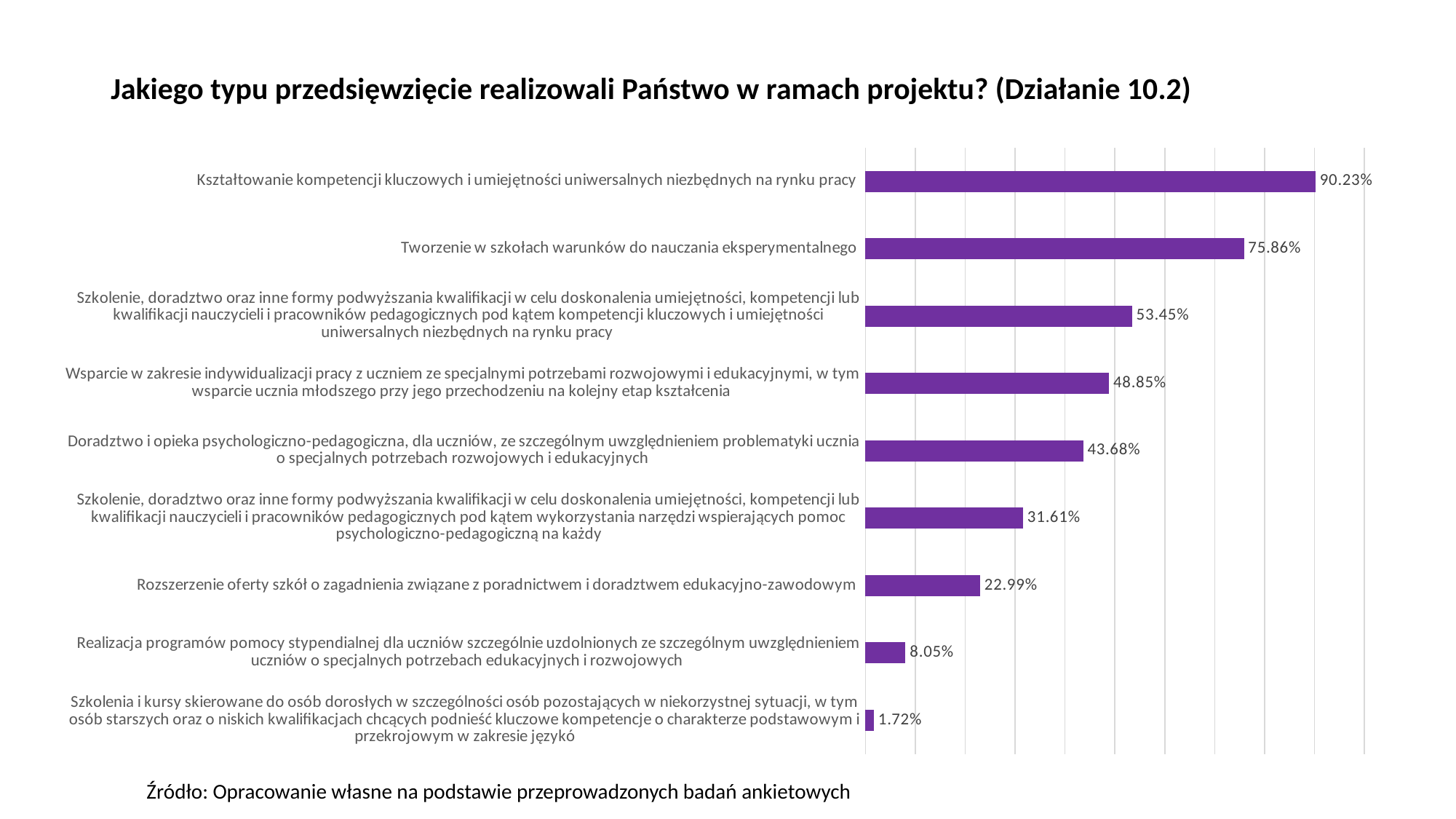
What is the difference between the values for "Kształtowanie kompetencji kluczowych..." (90.23%) and "Tworzenie w szkołach warunków do nauczania eksperymentalnego" (75.86%)? 14.37 percentage points What is the difference between "Rozszerzenie oferty szkół o zagadnienia związane z poradnictwem..." (22.99%) and "Realizacja programów pomocy stypendialnej..." (8.05%)? 14.94 percentage points Which is larger: the value for "Wsparcie w zakresie indywidualizacji pracy z uczniem..." or for "Doradztwo i opieka psychologiczno-pedagogiczna..."? Wsparcie w zakresie indywidualizacji pracy z uczniem... What value is shown for "Rozszerzenie oferty szkół o zagadnienia związane z poradnictwem i doradztwem edukacyjno-zawodowym"? 22.99% How many categories are plotted in the chart? 9 Which category has the highest value? Kształtowanie kompetencji kluczowych i umiejętności uniwersalnych niezbędnych na rynku pracy What colour are the bars in the chart? Purple Which category has the lowest value? Szkolenia i kursy skierowane do osób dorosłych w szczególności osób pozostających w niekorzystnej sytuacji... What percentage is shown for "Realizacja programów pomocy stypendialnej dla uczniów szczególnie uzdolnionych..."? 8.05% What is the title of the chart? Jakiego typu przedsięwzięcie realizowali Państwo w ramach projektu? (Działanie 10.2) What percentage is shown for "Tworzenie w szkołach warunków do nauczania eksperymentalnego"? 75.86% What type of chart is shown on the slide? Bar chart